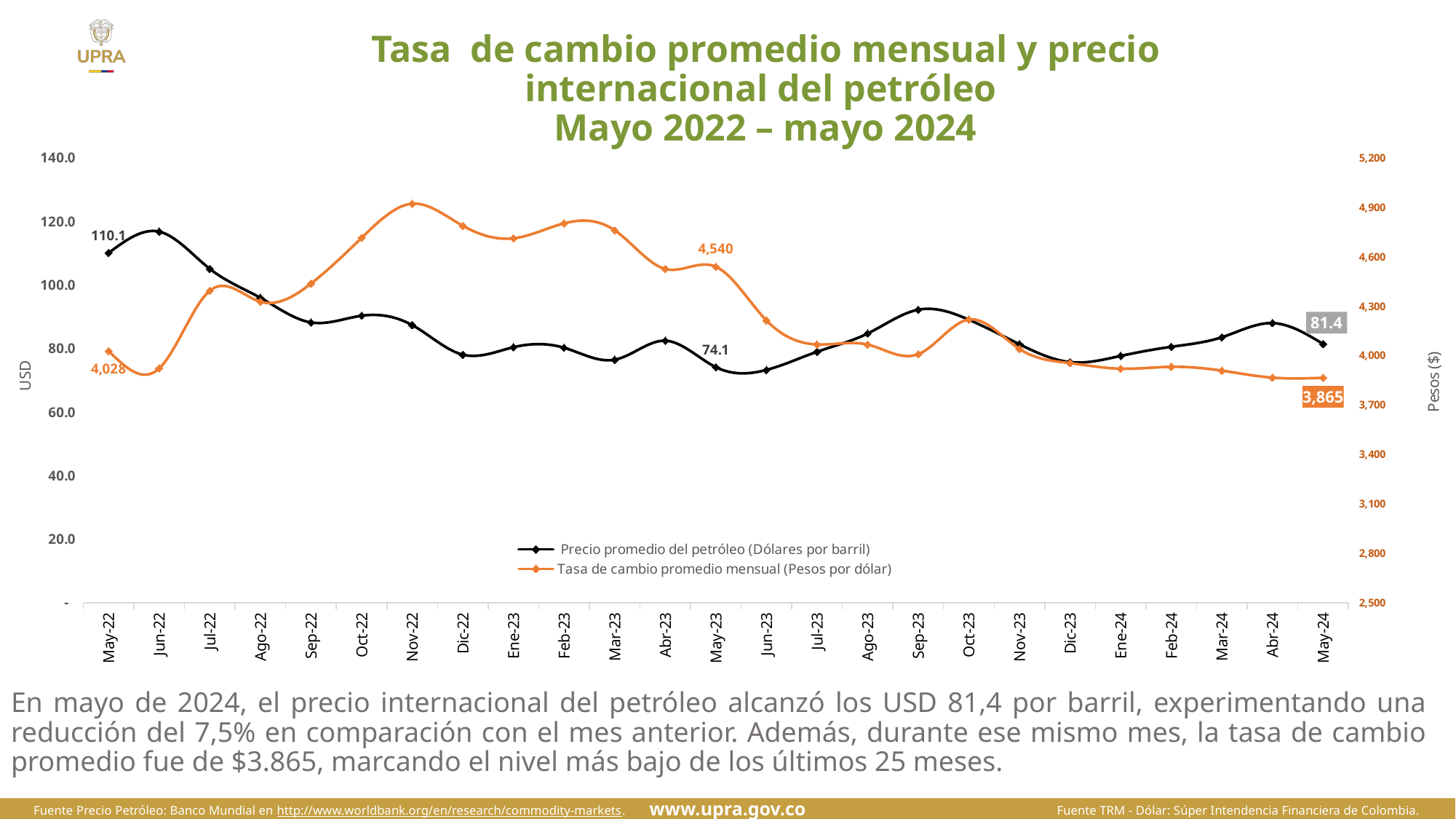
How many months are plotted along the x axis? 25 What is the difference between the Precio promedio del petróleo in May-22 (110.1) and in May-24 (81.4)? 28.7 What is the difference between the Tasa de cambio promedio mensual in May-23 (4,540) and in May-24 (3,865)? 675 What is the value of Tasa de cambio promedio mensual for May-23? 4,540 What is the value of Tasa de cambio promedio mensual for May-22? 4,028 In which month does the Tasa de cambio promedio mensual reach its lowest value? May-24 What kind of chart is shown on the slide? line chart How many series does the legend list? 2 Which is larger, the Precio promedio del petróleo in May-23 or in May-24? May-24 Is the Precio promedio del petróleo for Jun-22 greater or less than 100.0? greater What is the value of Precio promedio del petróleo for May-24? 81.4 In which month does the Tasa de cambio promedio mensual reach its highest value? Nov-22